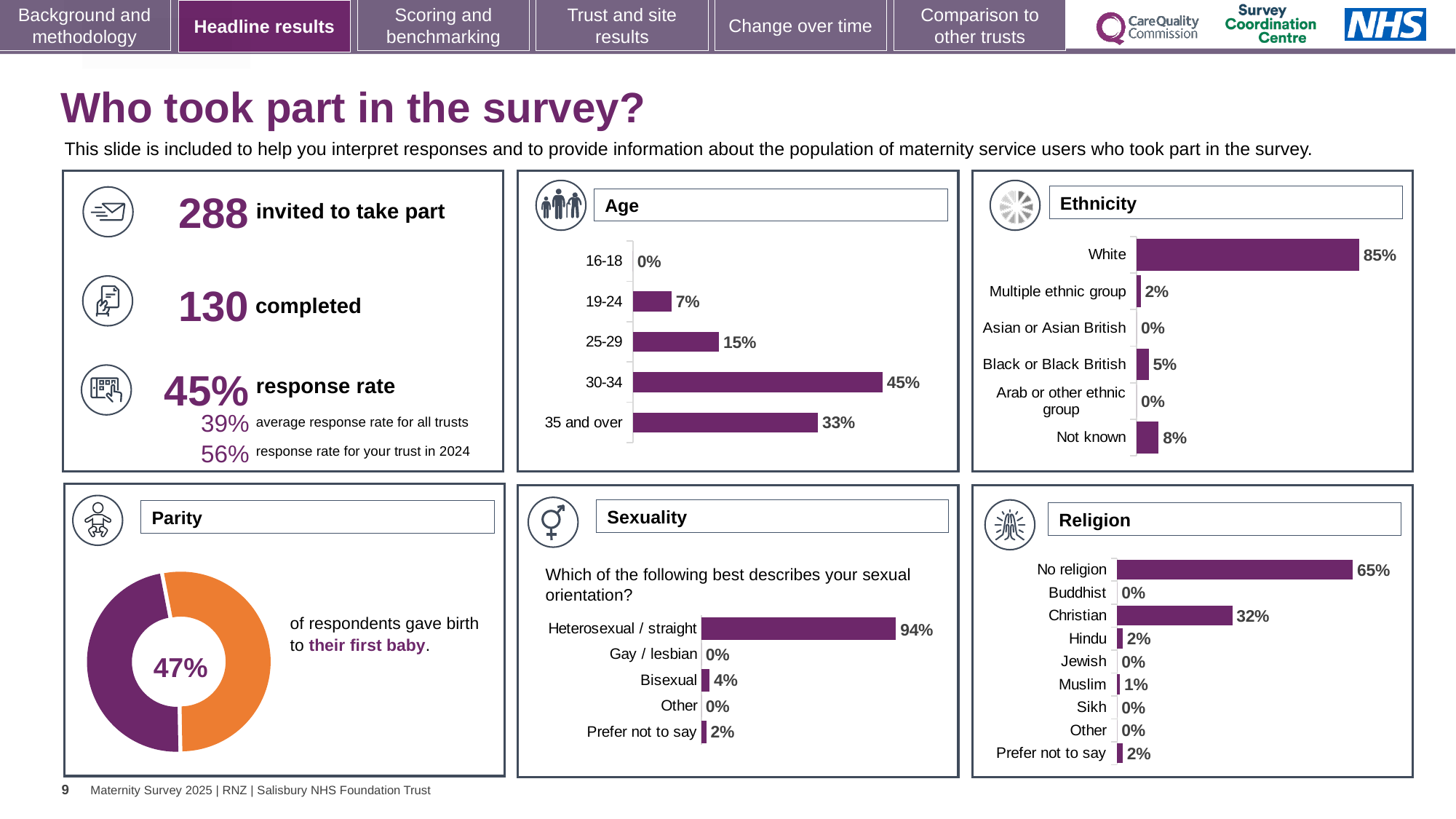
In the Age chart, what percentage of respondents were aged 30-34? 45% In the Age chart, which age group has the highest percentage? 30-34 In the Parity chart, what percentage of respondents gave birth to their first baby? 47% In the Ethnicity chart, what percentage of respondents were Not known? 8% In the Sexuality chart, what kind of chart is used? bar chart In the Age chart, what is the difference between the 30-34 and 35 and over percentages? 12% In the Ethnicity chart, what percentage of respondents were White? 85% In the Religion chart, how many religion categories are listed? 9 In the Sexuality chart, what percentage of respondents described themselves as Bisexual? 4% In the Age chart, how many age categories are shown? 5 In the Religion chart, what percentage of respondents were Christian? 32% In the Ethnicity chart, which is larger: Black or Black British or Multiple ethnic group? Black or Black British